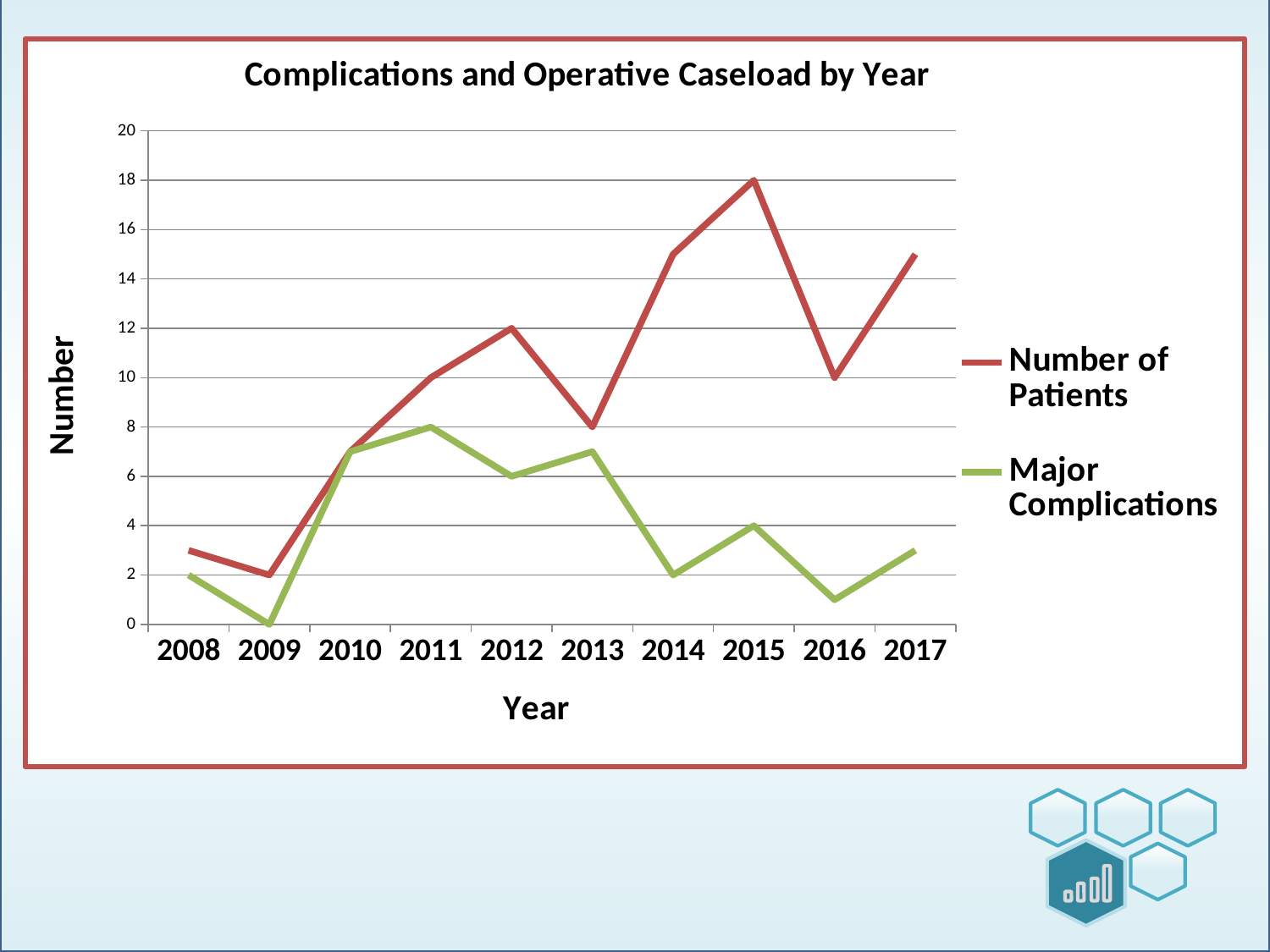
How many years are plotted along the x axis? 10 What is the value for Major Complications in 2011? 8 How many series does the legend list? 2 In which year is the Number of Patients highest? 2015 What is the Number of Patients in 2012? 12 What type of chart is shown on the slide? line chart Is the Number of Patients in 2017 greater or less than 12? greater What is the title of the chart? Complications and Operative Caseload by Year What is the difference between the Number of Patients in 2015 and in 2012? 6 What is the Number of Patients in 2015? 18 In which year is Major Complications lowest? 2009 Does the Number of Patients rise or fall from 2009 to 2012? rise